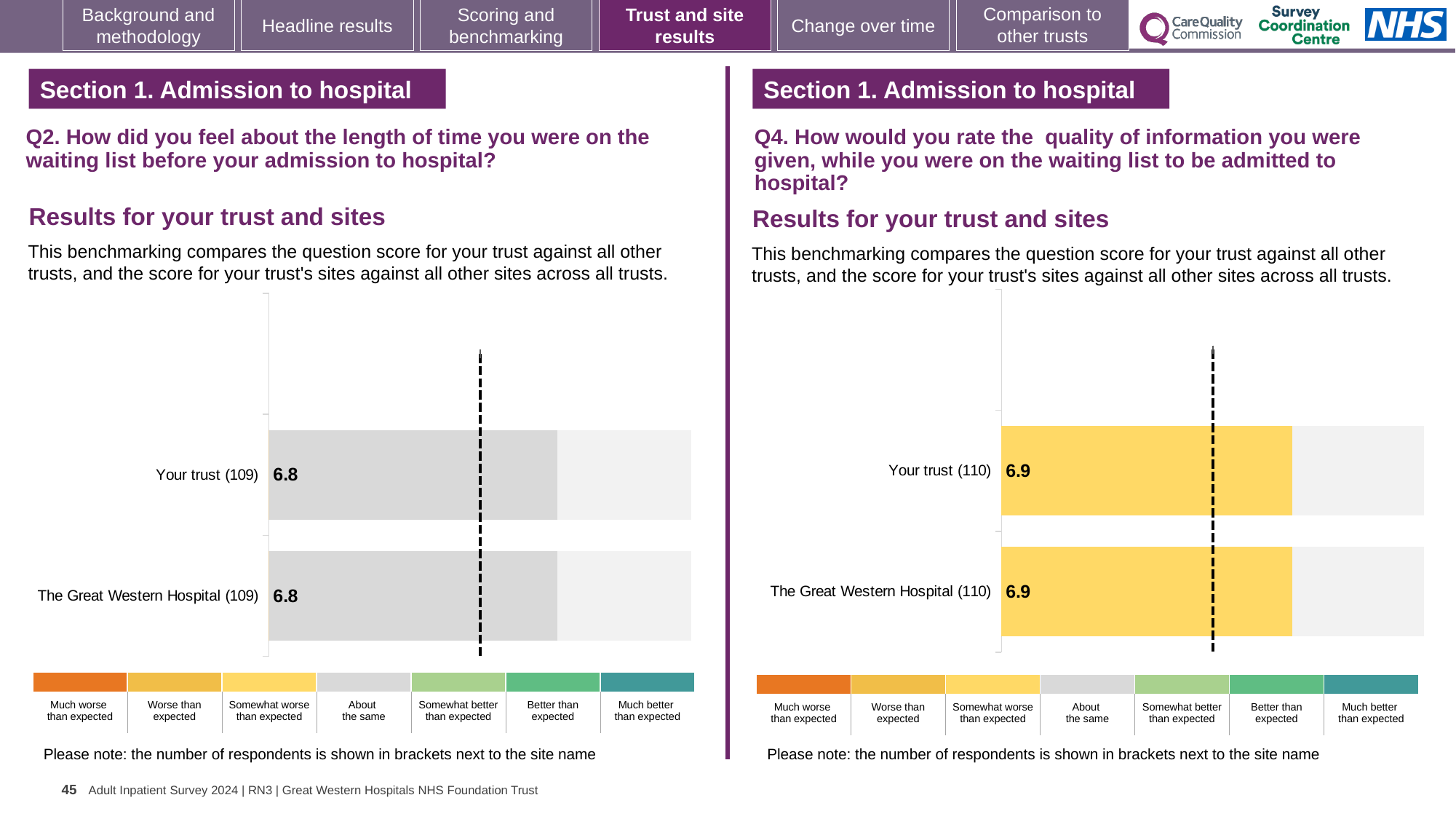
On the Q4 chart (right), what is the difference between the score for Your trust (110) and The Great Western Hospital (110)? 0 On the Q4 chart (right), what is the score for The Great Western Hospital (110)? 6.9 On the Q2 chart (left), what is the score for The Great Western Hospital (109)? 6.8 On the Q2 chart (left), what is the score for Your trust (109)? 6.8 How many bars are plotted on the Q2 chart (left)? 2 On the Q2 chart (left), how many respondents are shown in brackets for Your trust? 109 On the Q2 chart (left), what is the difference between the score for Your trust (109) and The Great Western Hospital (109)? 0 On the Q4 chart (right), which benchmark category does the yellow bar colour correspond to in the key? Somewhat worse than expected How many bars are plotted on the Q4 chart (right)? 2 On the Q4 chart (right), what is the score for Your trust (110)? 6.9 Is the score for Your trust (110) on the Q4 chart (right) greater or less than the score for Your trust (109) on the Q2 chart (left)? greater What kind of chart is the Q2 chart (left)? Bar chart